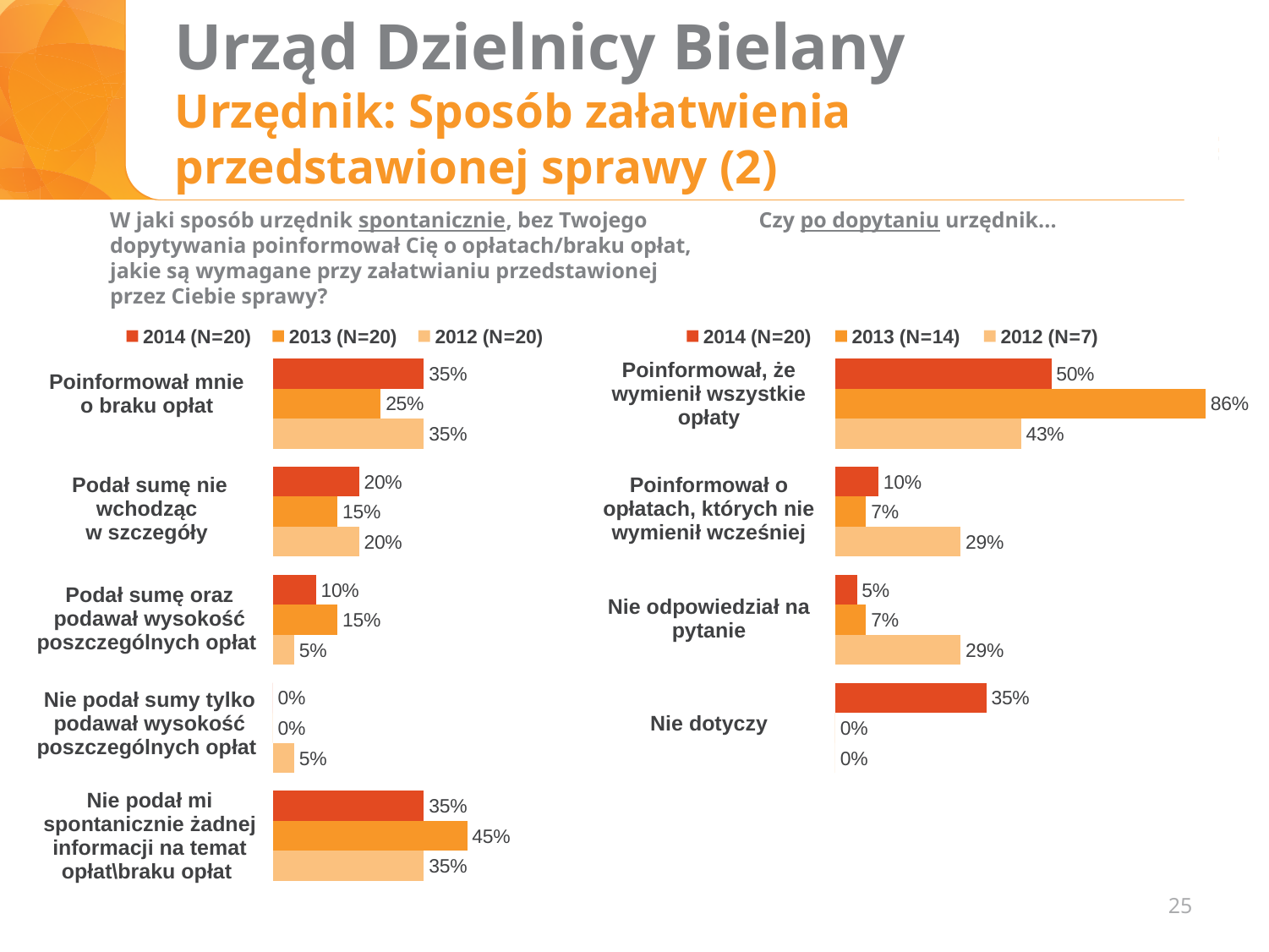
In the right chart, what is the 2012 (N=7) value for "Nie odpowiedział na pytanie"? 29% How many series does the legend of the left chart list? 3 How many categories does the right chart show? 4 In the left chart, what is the difference between the 2014 and 2013 values for "Poinformował mnie o braku opłat"? 10 percentage points In the left chart, what is the 2014 value for "Podał sumę oraz podawał wysokość poszczególnych opłat"? 10% What type of chart is used on the left side of the slide? Bar chart In the left chart, which is larger for "Podał sumę nie wchodząc w szczegóły": the 2014 value or the 2013 value? 2014 In the right chart, what is the 2013 (N=14) value for "Poinformował, że wymienił wszystkie opłaty"? 86% In the right chart, which category has the highest 2014 value? Poinformował, że wymienił wszystkie opłaty In the left chart, what is the 2013 value for "Nie podał mi spontanicznie żadnej informacji na temat opłat\braku opłat"? 45% In the left chart, which category has the lowest 2012 value? Podał sumę oraz podawał wysokość poszczególnych opłat and Nie podał sumy tylko podawał wysokość poszczególnych opłat (both 5%) In the right chart, what is the difference between the 2013 and 2014 values for "Poinformował, że wymienił wszystkie opłaty"? 36 percentage points